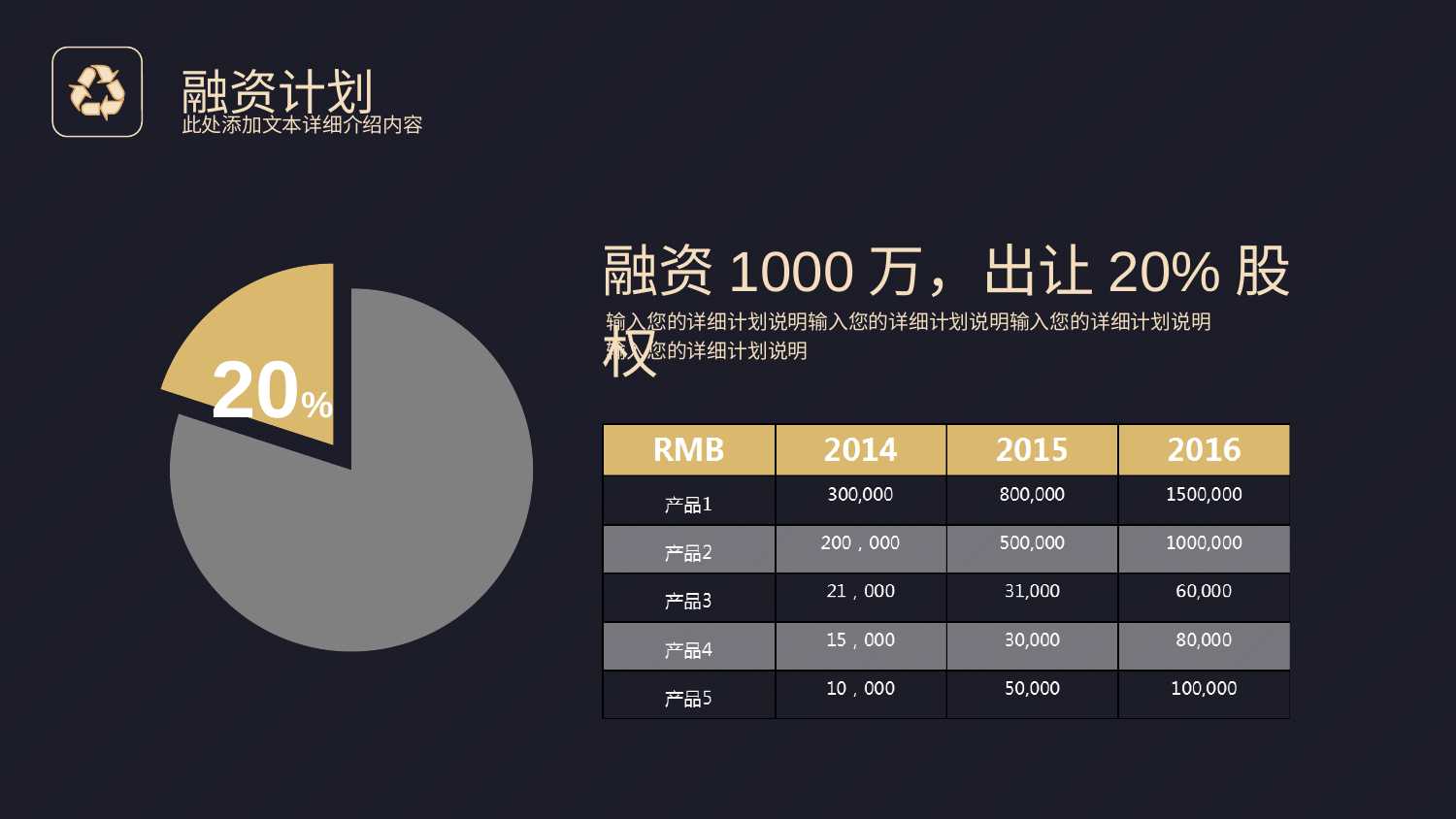
What share of the pie chart does the gold (highlighted) slice represent? 20% What kind of chart is shown on the left of the slide? pie chart Which slice of the pie chart is larger, the gold slice or the grey slice? the grey slice What is the only percentage label printed on the pie chart? 20% What colour is the slice labelled 20% in the pie chart? gold Which slice of the pie chart is the smallest? the gold slice (20%) How many slices does the pie chart have? 2